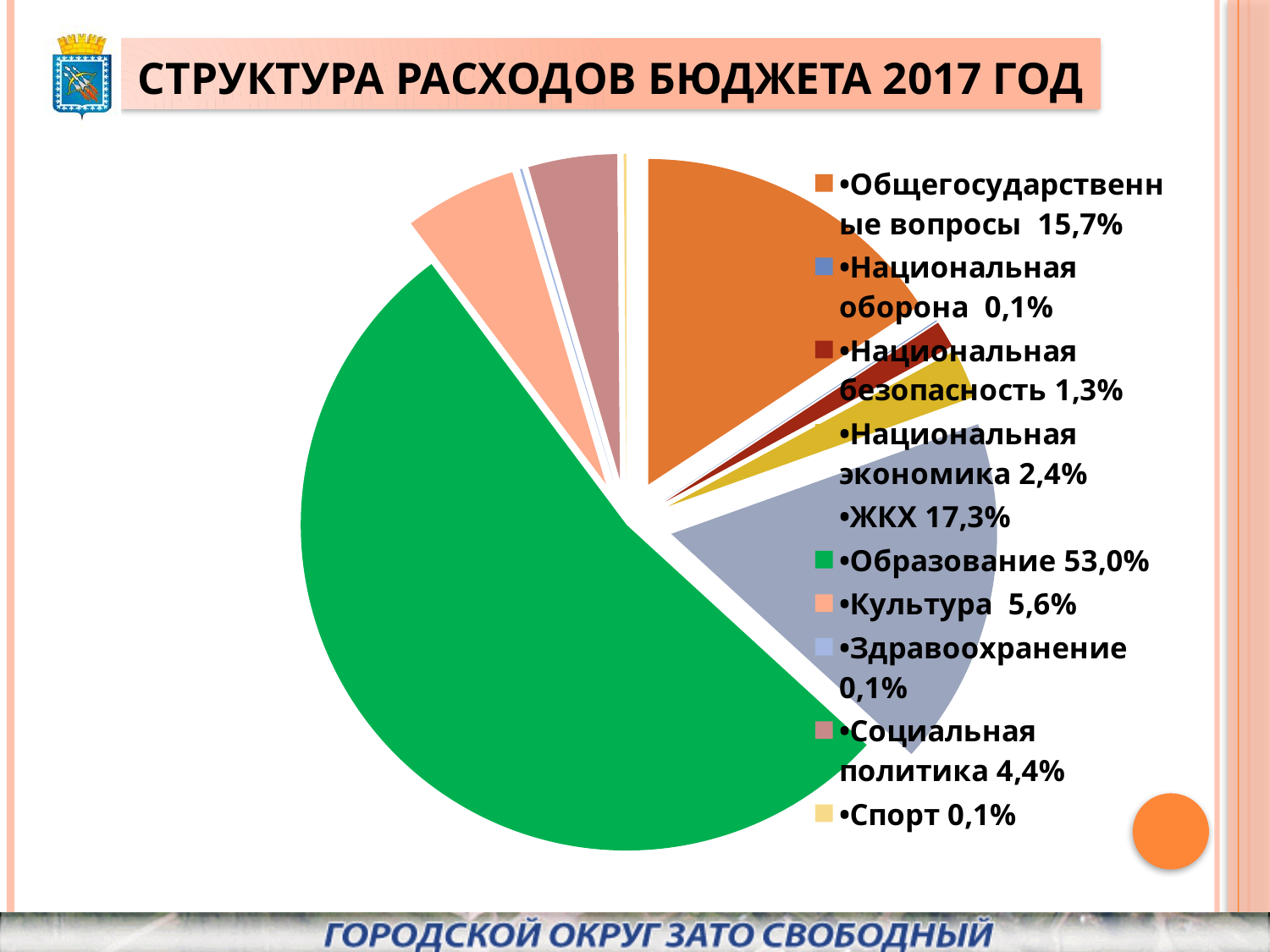
What colour is the slice for Образование? green What is the value for Социальная политика? 4,4% What is the value for ЖКХ? 17,3% Which category has the largest share of the pie? Образование What share of the budget expenditure goes to Образование? 53,0% What is the value for Общегосударственные вопросы? 15,7% What is the difference between the shares of Образование and ЖКХ? 35,7% Which is larger, ЖКХ or Общегосударственные вопросы? ЖКХ What is the title of the chart on the slide? СТРУКТУРА РАСХОДОВ БЮДЖЕТА 2017 ГОД What is the value for Культура? 5,6% What kind of chart is shown on the slide? pie chart How many categories does the legend of the pie chart list? 10